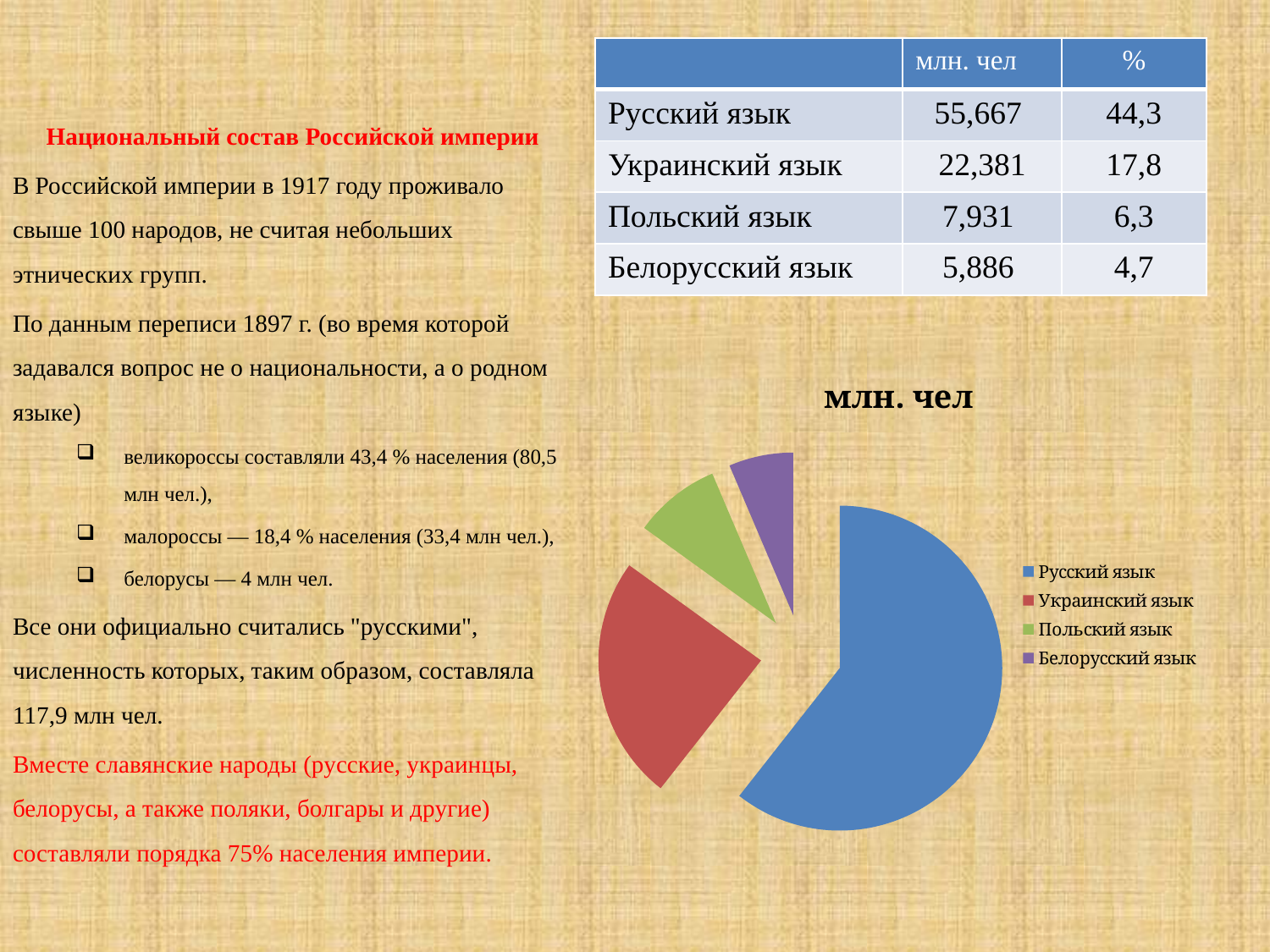
What is the title of the pie chart? млн. чел According to the table on the slide, what percentage is shown for Польский язык? 6,3 In the pie chart, which slice is larger: Польский язык or Белорусский язык? Польский язык Which category has the largest slice in the pie chart? Русский язык Which category has the smallest slice in the pie chart? Белорусский язык How many slices does the pie chart have? 4 According to the table on the slide, what is the value in млн. чел for Русский язык? 55,667 What colour is the Русский язык slice in the pie chart? blue What kind of chart is shown on the slide? pie chart How many entries does the pie chart's legend list? 4 According to the table on the slide, what is the value in млн. чел for Украинский язык? 22,381 In the pie chart, which slice is larger: Русский язык or Украинский язык? Русский язык